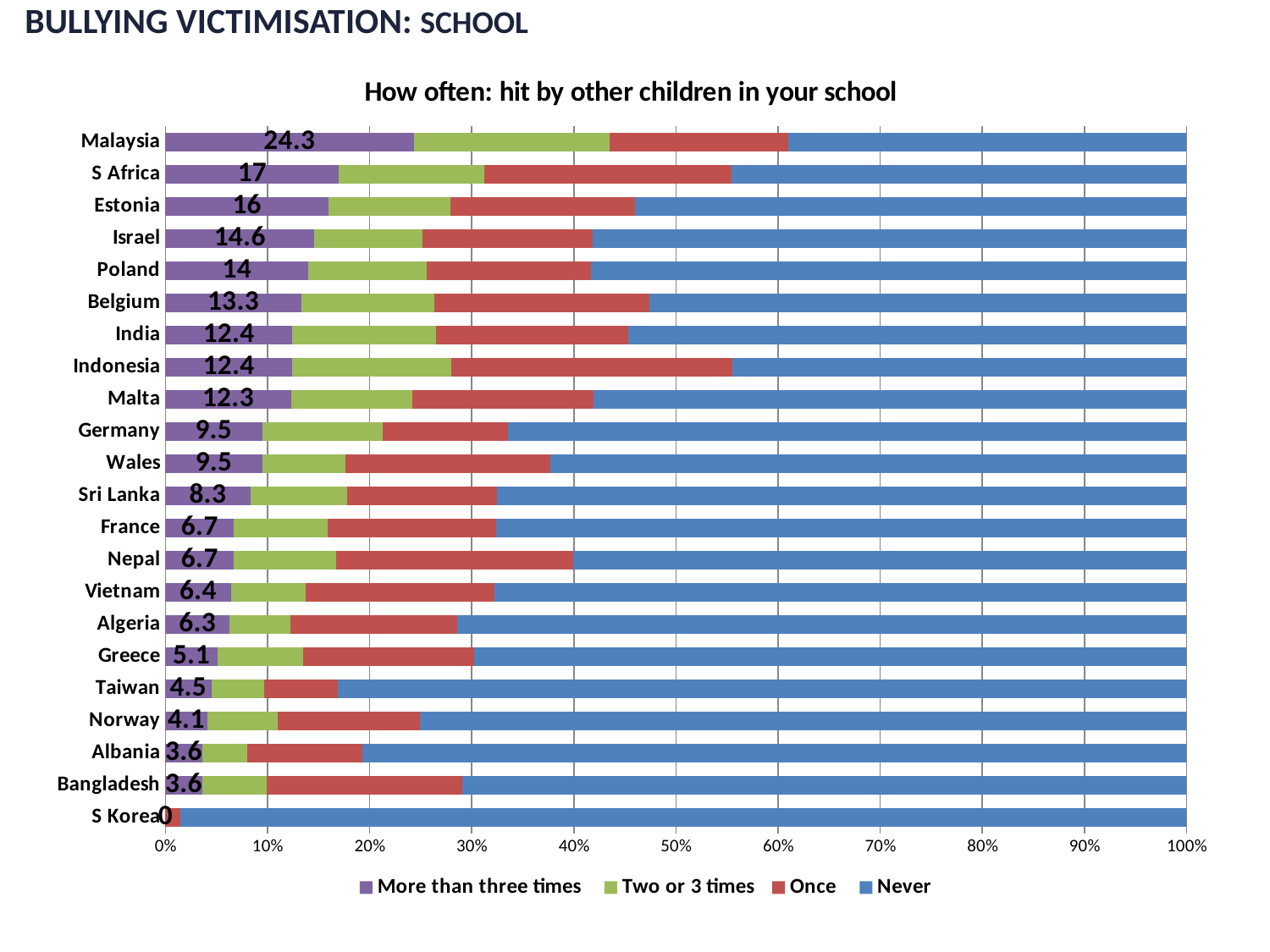
Which has a larger 'More than three times' value, Estonia or Israel? Estonia How many countries are shown in the chart? 22 Which country has the highest 'More than three times' value? Malaysia How many series does the legend list? 4 What is the 'More than three times' value for Malaysia? 24.3 Is the 'Never' value for S Korea greater or less than 90%? greater What is the 'More than three times' value for Norway? 4.1 What is the difference between the 'More than three times' values for Malaysia and S Africa? 7.3 What type of chart is shown on the slide? stacked bar chart What is the 'More than three times' value for Belgium? 13.3 Which country has the lowest 'More than three times' value? S Korea What is the title of the chart? How often: hit by other children in your school